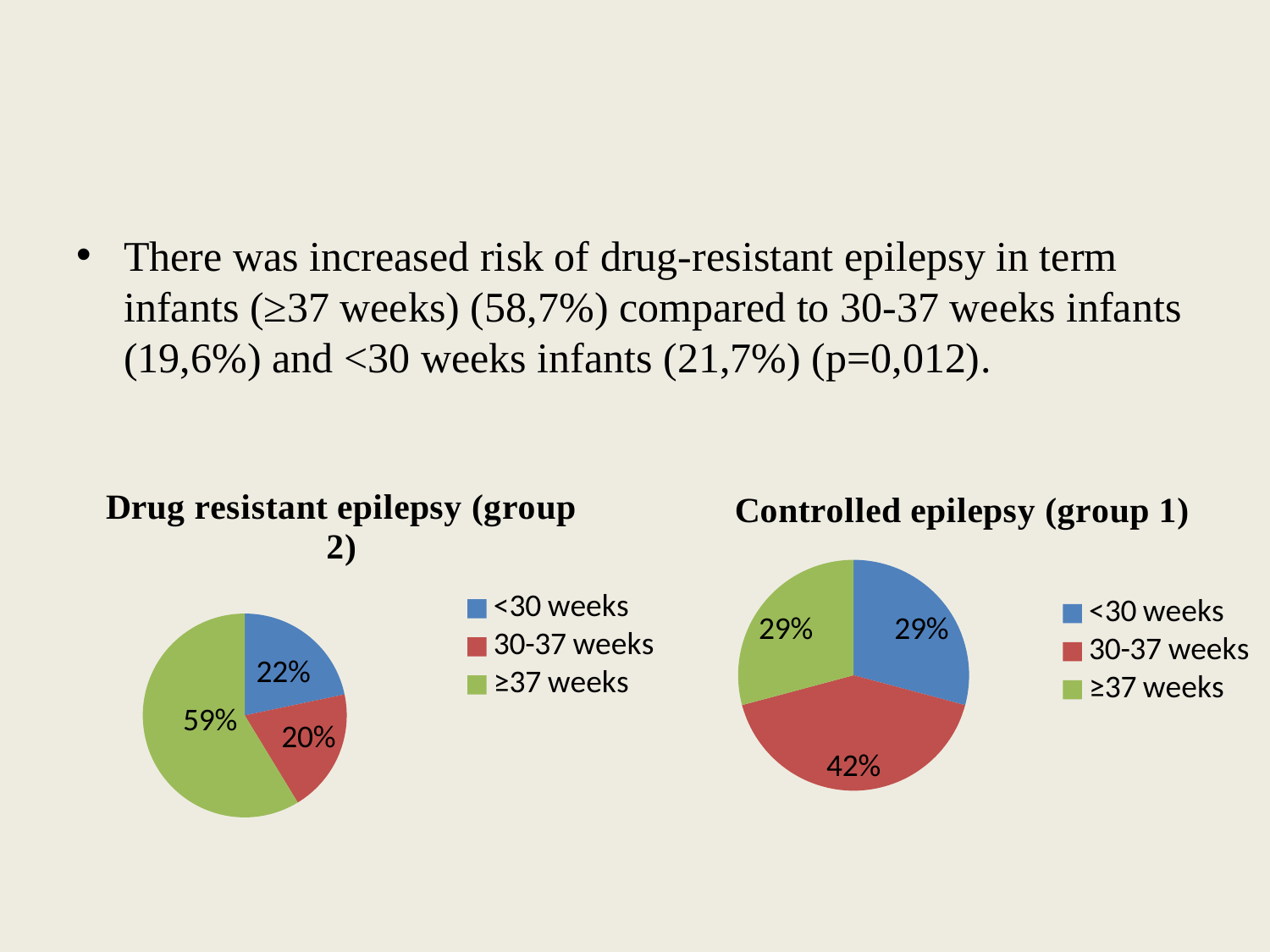
In the 'Controlled epilepsy (group 1)' chart, what share is shown for <30 weeks? 29% In the 'Controlled epilepsy (group 1)' chart, what is the difference between the 30-37 weeks share and the ≥37 weeks share? 13% In the 'Drug resistant epilepsy (group 2)' chart, which category has the largest slice? ≥37 weeks In the 'Drug resistant epilepsy (group 2)' chart, what share is shown for 30-37 weeks? 20% In the 'Drug resistant epilepsy (group 2)' chart, what share is shown for <30 weeks? 22% In the 'Controlled epilepsy (group 1)' chart, which category has the largest slice? 30-37 weeks What type of chart is the 'Controlled epilepsy (group 1)' chart? Pie chart In the 'Drug resistant epilepsy (group 2)' chart, which category has the smallest slice? 30-37 weeks In the 'Controlled epilepsy (group 1)' chart, what share is shown for 30-37 weeks? 42% How many categories does the legend of the 'Drug resistant epilepsy (group 2)' chart list? 3 In the 'Drug resistant epilepsy (group 2)' chart, what share is shown for ≥37 weeks? 59% In the 'Drug resistant epilepsy (group 2)' chart, what is the difference between the ≥37 weeks share and the <30 weeks share? 37%